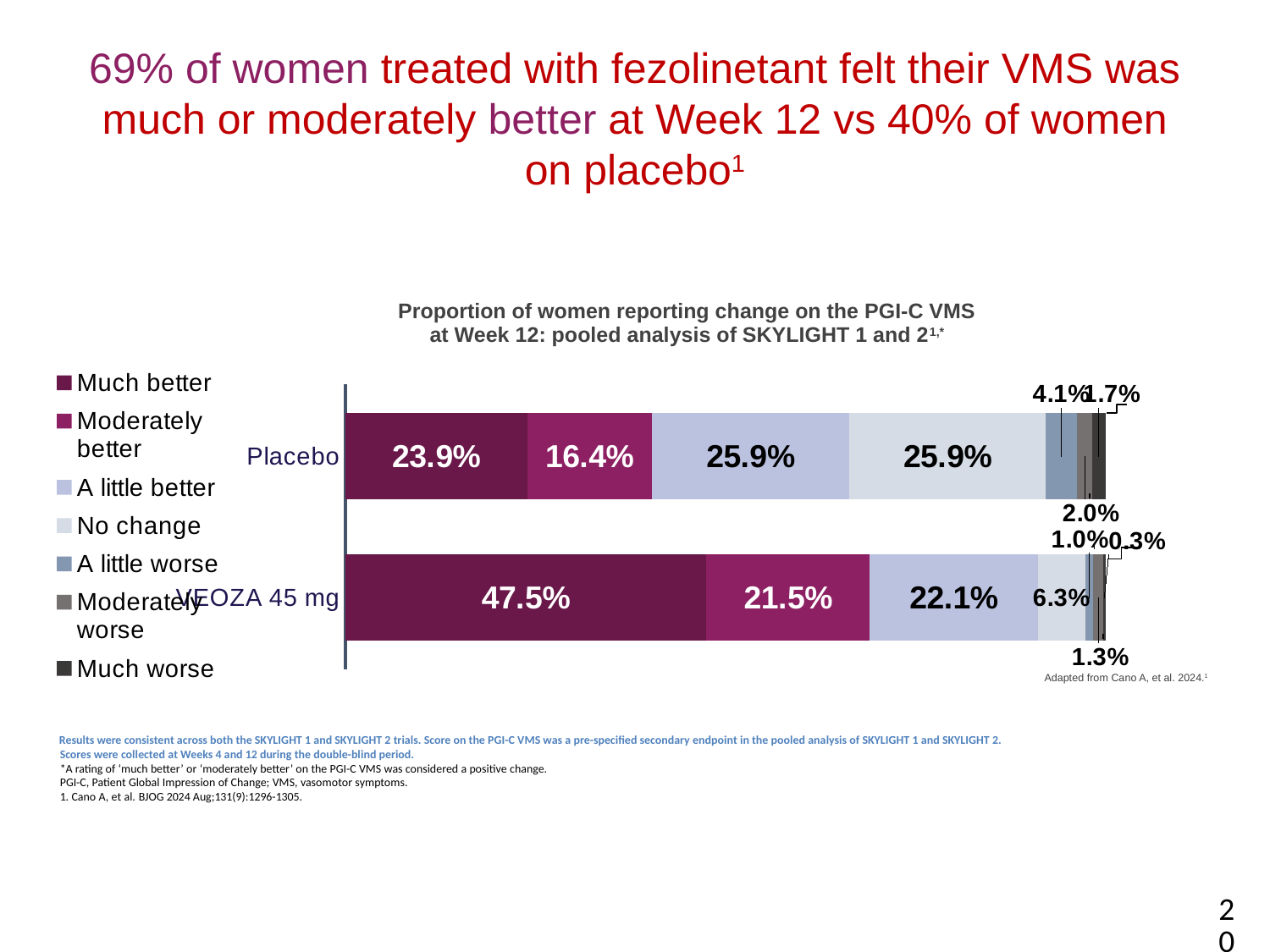
How many treatment groups (bars) are plotted in the chart? 2 What percentage of women on Placebo reported 'Much better'? 23.9% What percentage of women on VEOZA 45 mg reported 'Much better'? 47.5% Which response category is the largest segment in the VEOZA 45 mg bar? Much better What is the title of the chart? Proportion of women reporting change on the PGI-C VMS at Week 12: pooled analysis of SKYLIGHT 1 and 2 What percentage of women on Placebo reported 'Moderately better'? 16.4% How many series does the legend list? 7 What is the difference in the 'No change' proportion between Placebo and VEOZA 45 mg? 19.6% What type of chart is shown on the slide? Stacked bar chart What percentage of women on VEOZA 45 mg reported 'No change'? 6.3% What is the difference in the 'Much better' proportion between VEOZA 45 mg and Placebo? 23.6% Which group had the larger 'Much better' proportion, Placebo or VEOZA 45 mg? VEOZA 45 mg